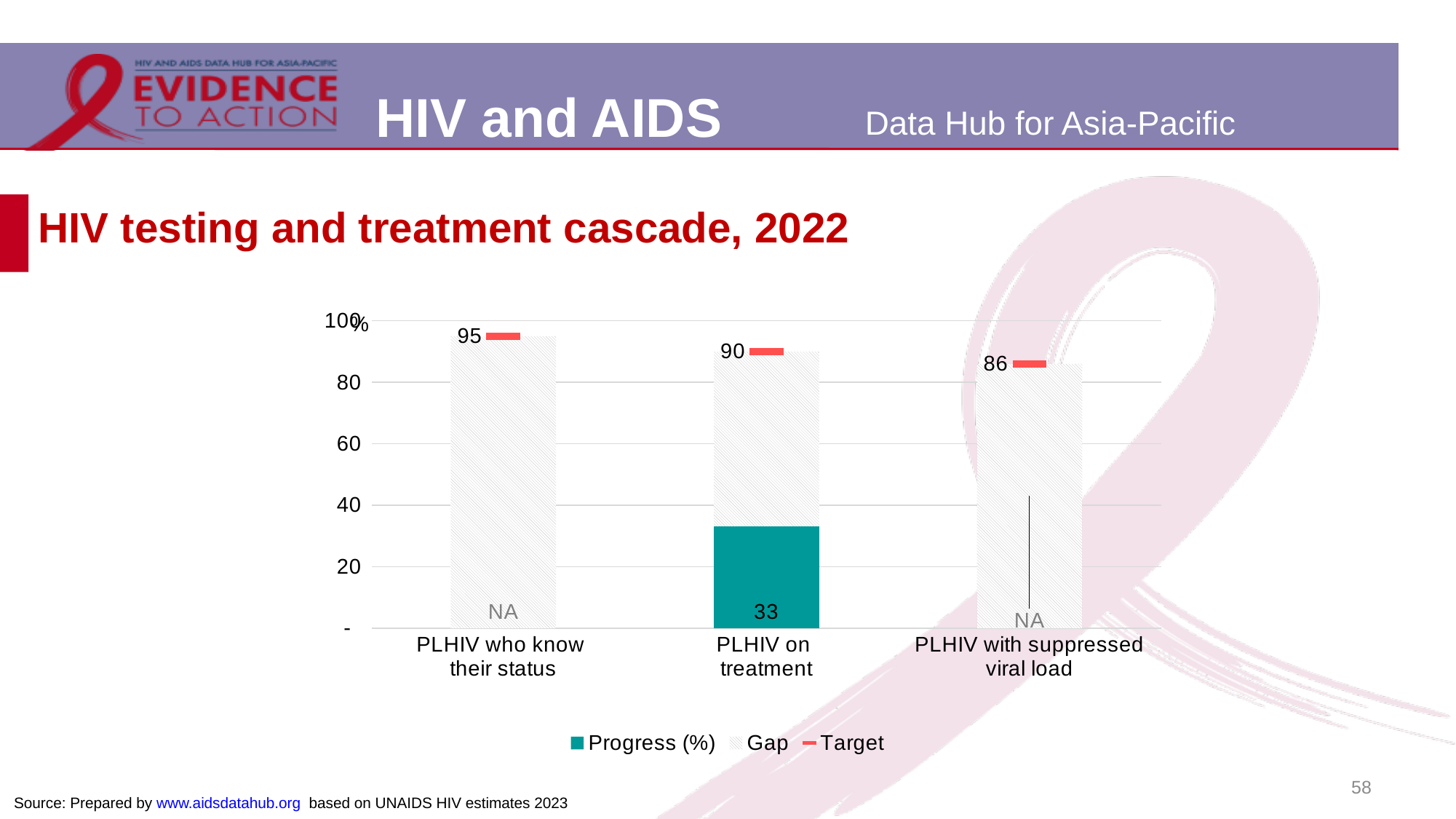
What is the Target value for PLHIV with suppressed viral load? 86 Which category has the highest Target value? PLHIV who know their status What is the Target value for PLHIV who know their status? 95 What is the Target value for PLHIV on treatment? 90 Which category has the lowest Target value? PLHIV with suppressed viral load How many categories are shown on the x axis? 3 What is the difference between the Target values for PLHIV who know their status and PLHIV with suppressed viral load? 9 What is the Progress (%) value for PLHIV on treatment? 33 How many series does the legend list? 3 What kind of chart is shown on the slide? bar chart What is the Progress (%) label shown for PLHIV who know their status? NA Is the Progress (%) value for PLHIV on treatment greater or less than 40? less